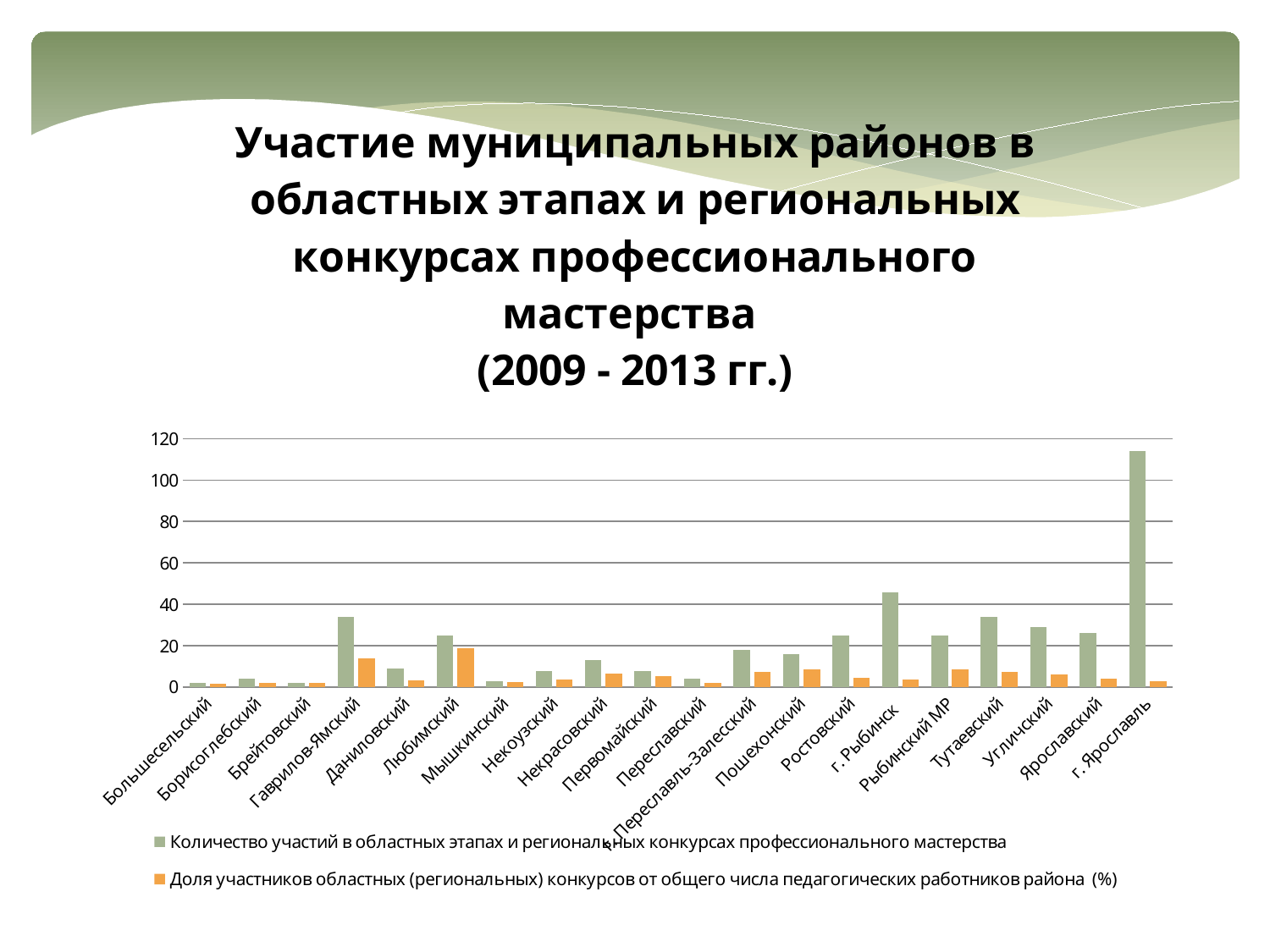
Is the value for г. Рыбинск in the series 'Количество участий в областных этапах и региональных конкурсах профессионального мастерства' greater or less than 40? greater Is the value for Любимский in the series 'Доля участников областных (региональных) конкурсов от общего числа педагогических работников района (%)' greater or less than 10? greater How many municipal districts (categories) are shown on the x axis? 20 Is the value for г. Ярославль in the series 'Количество участий в областных этапах и региональных конкурсах профессионального мастерства' greater or less than 100? greater What kind of chart is shown on the slide? bar chart How many series does the legend list? 2 Which district has the highest value for 'Доля участников областных (региональных) конкурсов от общего числа педагогических работников района (%)'? Любимский Which has the larger value for 'Количество участий в областных этапах и региональных конкурсах профессионального мастерства': Ростовский or Пошехонский? Ростовский Which district has the highest value for 'Количество участий в областных этапах и региональных конкурсах профессионального мастерства'? г. Ярославль Which has the larger value for 'Количество участий в областных этапах и региональных конкурсах профессионального мастерства': г. Рыбинск or Тутаевский? г. Рыбинск What colour represents the series 'Доля участников областных (региональных) конкурсов от общего числа педагогических работников района (%)' in the legend? orange